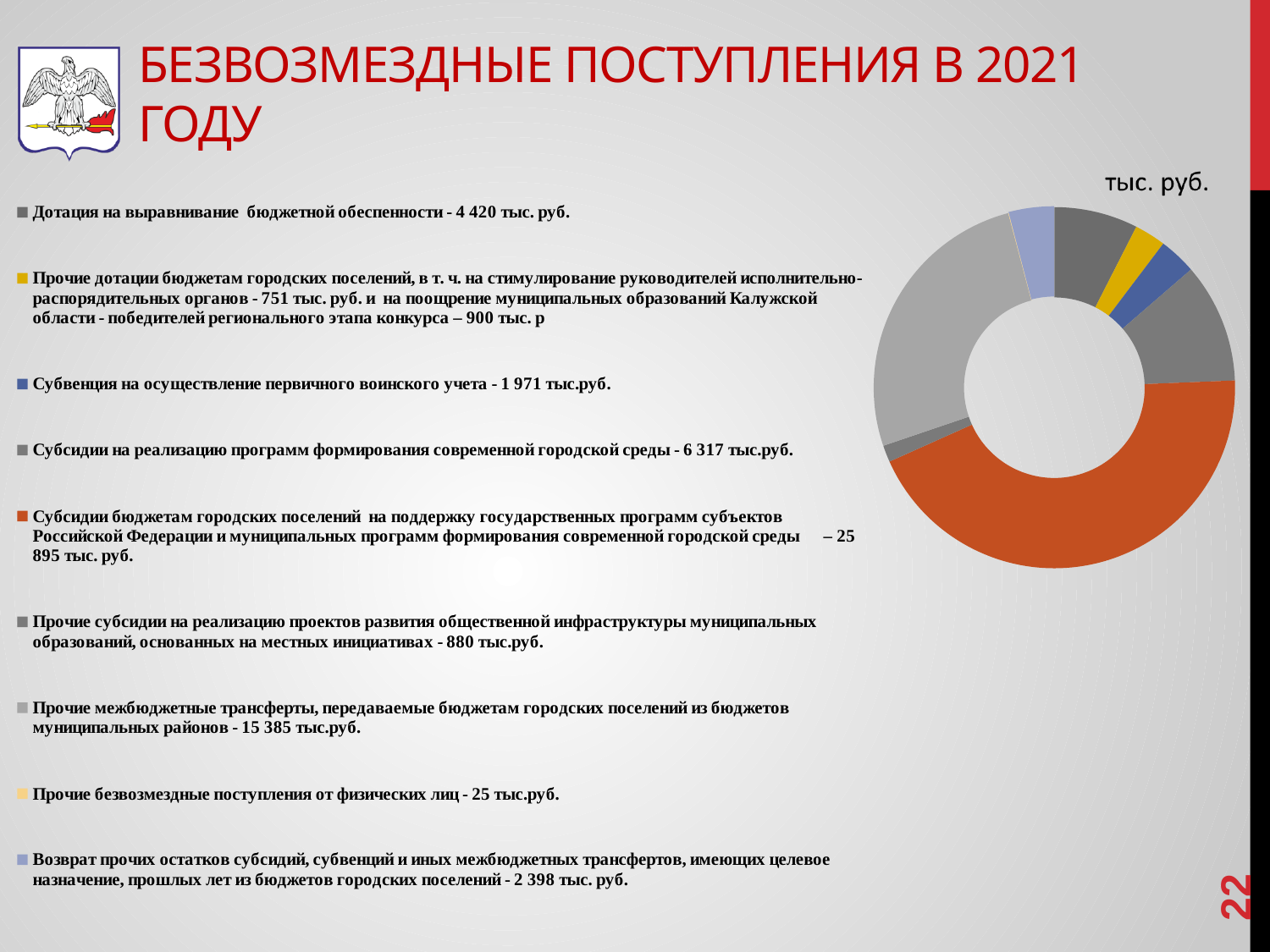
What is the value for 'Субвенция на осуществление первичного воинского учета'? 1 971 тыс.руб. What is the value for 'Дотация на выравнивание бюджетной обеспеченности'? 4 420 тыс. руб. What unit label is shown above the chart? тыс. руб. What is the value for 'Прочие межбюджетные трансферты, передаваемые бюджетам городских поселений из бюджетов муниципальных районов'? 15 385 тыс.руб. What is the value for 'Возврат прочих остатков субсидий, субвенций и иных межбюджетных трансфертов'? 2 398 тыс. руб. What kind of chart is shown on the slide? Doughnut (pie) chart Which category has the smallest value in the chart? Прочие безвозмездные поступления от физических лиц (25 тыс.руб.) What is the difference between the largest category (25 895) and 'Прочие межбюджетные трансферты' (15 385)? 10 510 тыс. руб. Which category has the largest value in the chart? Субсидии бюджетам городских поселений на поддержку государственных программ субъектов Российской Федерации и муниципальных программ формирования современной городской среды (25 895 тыс. руб.) What is the difference between 'Субсидии на реализацию программ формирования современной городской среды' (6 317) and 'Дотация на выравнивание бюджетной обеспеченности' (4 420)? 1 897 тыс. руб. Which is larger: 'Прочие субсидии на реализацию проектов развития общественной инфраструктуры' or 'Субвенция на осуществление первичного воинского учета'? Субвенция на осуществление первичного воинского учета How many categories does the legend of the chart list? 9